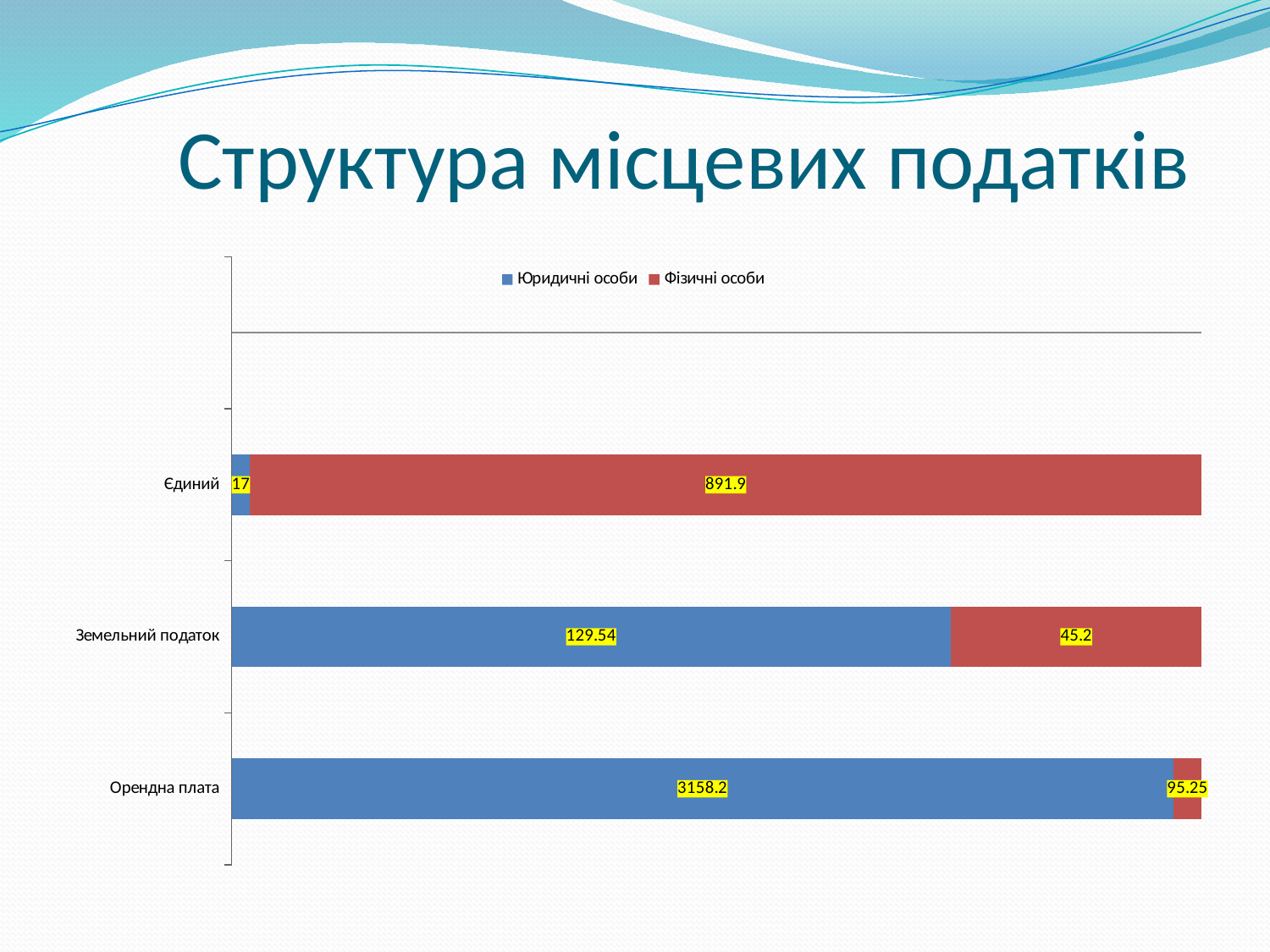
Which category has the highest value for Юридичні особи? Орендна плата Which category has the lowest value for Фізичні особи? Земельний податок What is the difference between the Фізичні особи and Юридичні особи values in the Єдиний category? 874.9 How many series does the legend list? 2 In the Земельний податок category, which series has the larger value, Юридичні особи or Фізичні особи? Юридичні особи What is the value for Фізичні особи in the Єдиний category? 891.9 What is the value for Юридичні особи in the Земельний податок category? 129.54 How many categories are shown on the chart? 3 What is the value for Юридичні особи in the Орендна плата category? 3158.2 What is the total of the stacked bar for Земельний податок? 174.74 What is the value for Фізичні особи in the Орендна плата category? 95.25 What kind of chart is shown on the slide? Stacked bar chart